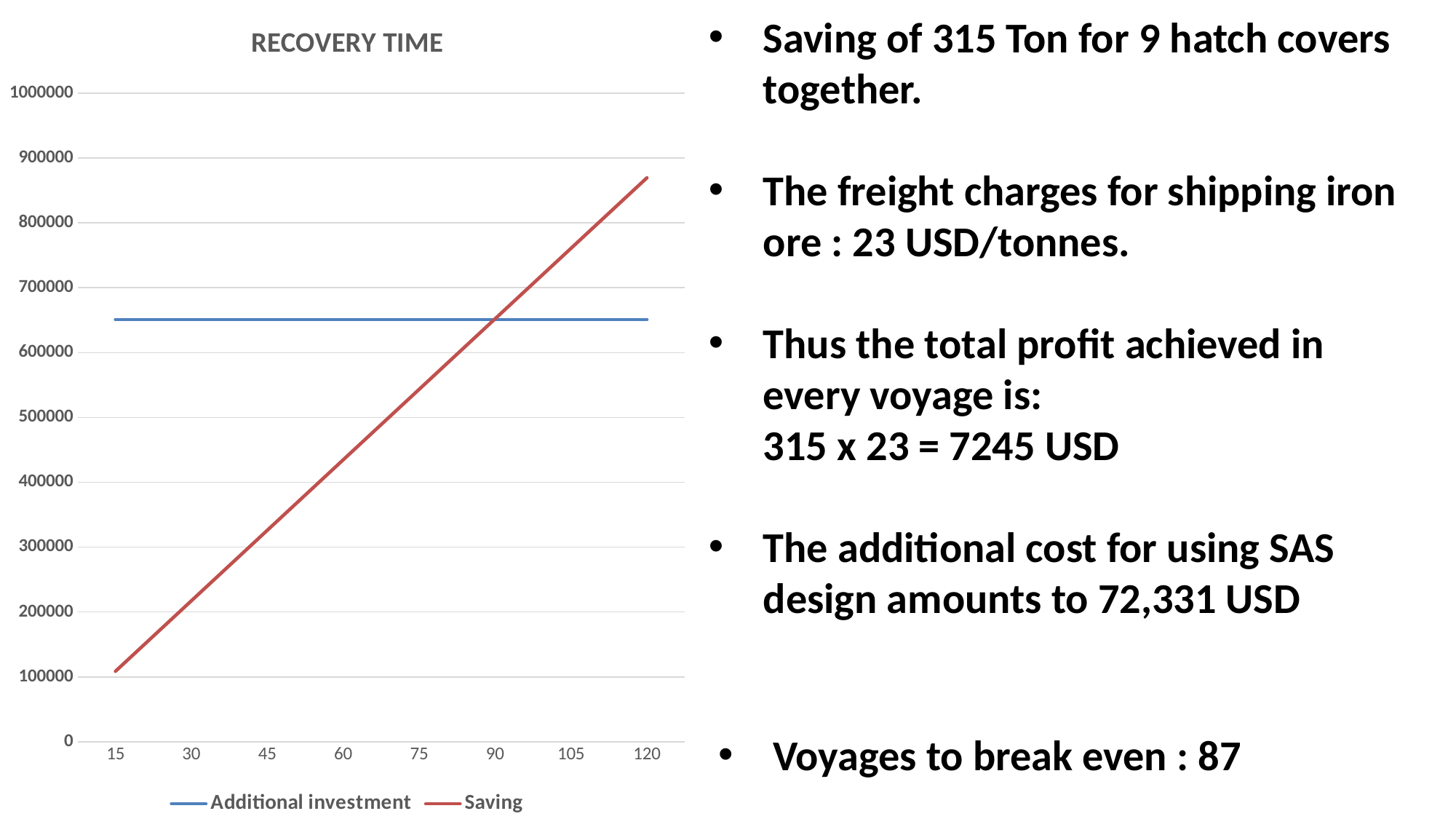
What kind of chart is shown on the slide? line chart How many series does the chart legend list? 2 Is the value of the Saving series at 120 greater or less than 800000? greater What is the title of the chart? RECOVERY TIME How many points are labelled along the x axis of the chart? 8 At x = 120, which series has the larger value, Additional investment or Saving? Saving Is the value of the Additional investment series greater or less than 700000? less At x = 30, which series has the larger value, Additional investment or Saving? Additional investment Does the Saving series rise or fall as the x axis increases from 15 to 120? rise Which series are listed in the chart legend? Additional investment, Saving Is the value of the Additional investment series greater or less than 600000? greater